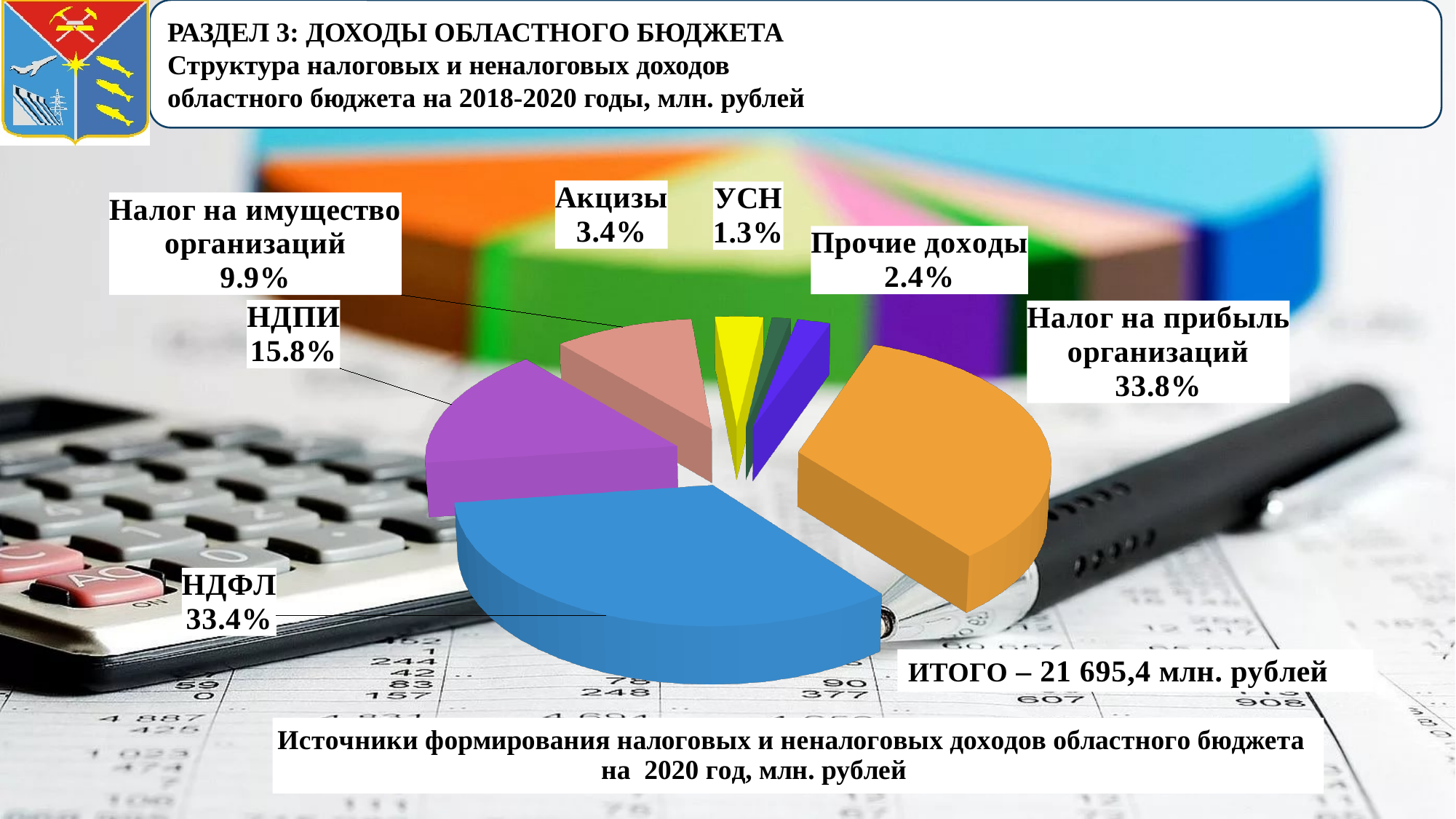
What is the difference between the shares of НДПИ and Налог на имущество организаций? 5.9% What total amount (ИТОГО) is stated on the slide? 21 695,4 млн. рублей What is the value shown for НДПИ? 15.8% How many categories (slices) does the pie chart have? 7 What share of the pie does Налог на прибыль организаций have? 33.8% What share of the pie does НДФЛ have? 33.4% What is the value shown for Налог на имущество организаций? 9.9% What is the value shown for Акцизы? 3.4% Which category has the smallest share of the pie? УСН What is the value shown for Прочие доходы? 2.4% Which category has the largest share of the pie? Налог на прибыль организаций What kind of chart is shown on the slide? pie chart